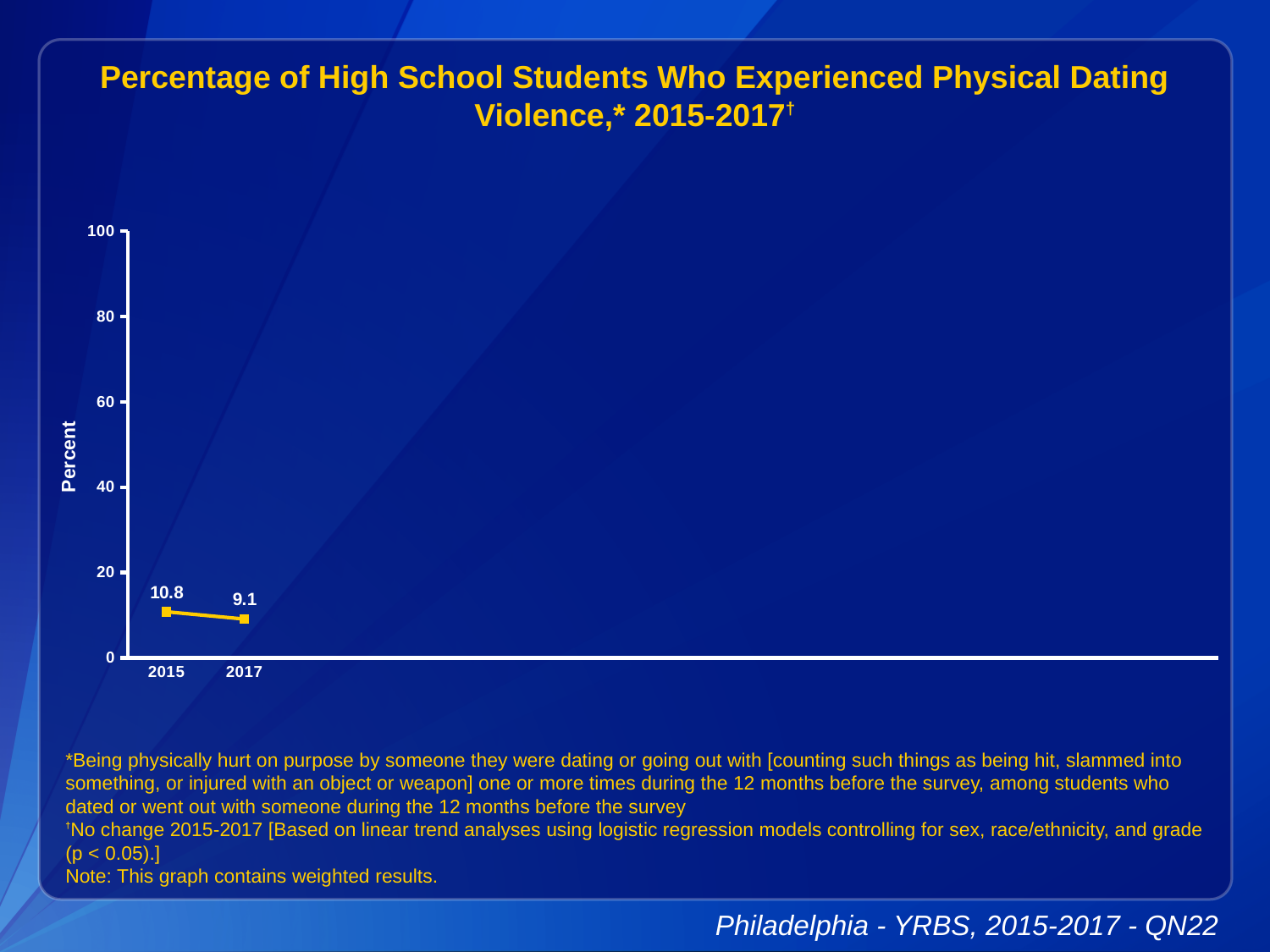
What is the label on the y axis of the chart? Percent Which year shows the highest percentage of students who experienced physical dating violence? 2015 What is the difference between the 2015 and 2017 percentages? 1.7 What kind of chart is shown on the slide? line chart What is the percentage of high school students who experienced physical dating violence in 2017? 9.1 How many years are plotted on the chart? 2 Which year has the higher percentage, 2015 or 2017? 2015 Is the value for 2015 greater or less than 20? less What is the percentage of high school students who experienced physical dating violence in 2015? 10.8 Do the values rise or fall from 2015 to 2017? fall What is the maximum value shown on the y axis? 100 Which year shows the lowest percentage of students who experienced physical dating violence? 2017